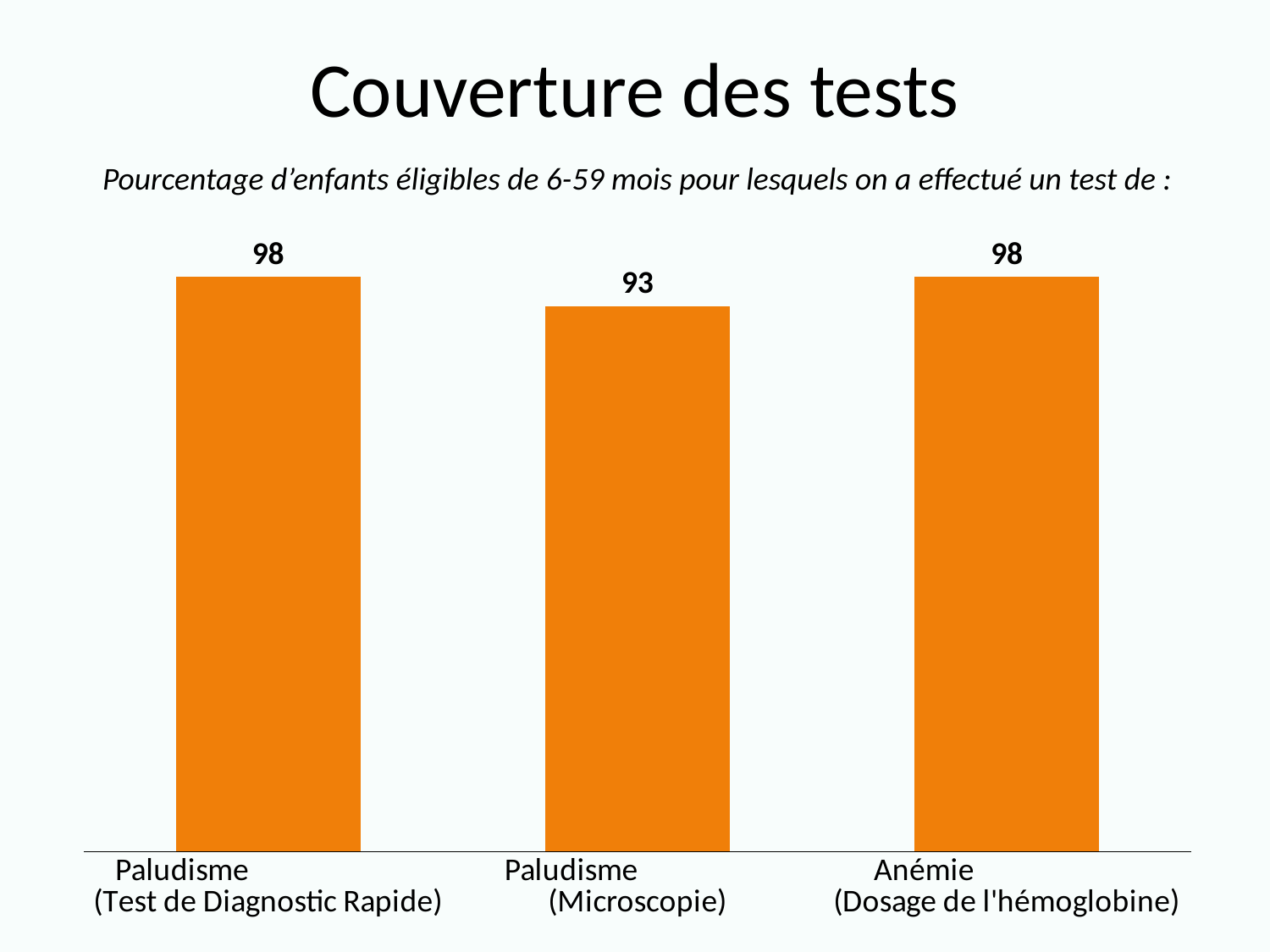
What is the difference between the values for Paludisme (Test de Diagnostic Rapide) and Paludisme (Microscopie)? 5 What is the value for Anémie (Dosage de l'hémoglobine)? 98 Do the values for Paludisme (Test de Diagnostic Rapide) and Anémie (Dosage de l'hémoglobine) have the same value? Yes Which category has the lowest value? Paludisme (Microscopie) Which is larger, the value for Anémie (Dosage de l'hémoglobine) or the value for Paludisme (Microscopie)? Anémie (Dosage de l'hémoglobine) How many categories are shown in the chart? 3 What is the value for Paludisme (Test de Diagnostic Rapide)? 98 What is the title of the slide? Couverture des tests What kind of chart is shown on the slide? Bar chart What colour are the bars in the chart? Orange What is the value for Paludisme (Microscopie)? 93